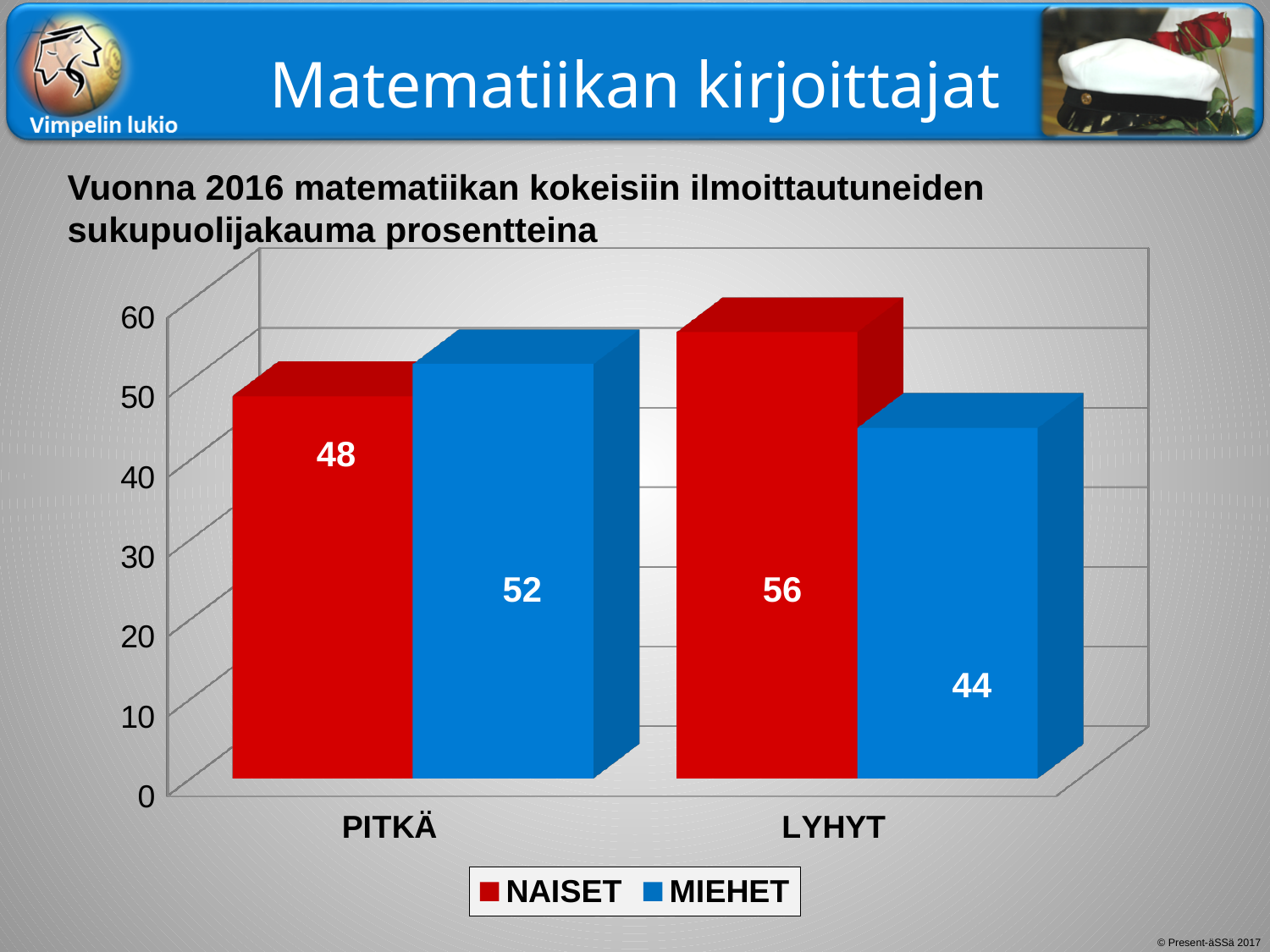
What kind of chart is shown on the slide? Bar chart Which colour represents the MIEHET series? Blue What is the value for NAISET in the PITKÄ category? 48 Which is larger: the NAISET value for PITKÄ or the NAISET value for LYHYT? LYHYT How many series does the legend list? 2 What is the value for MIEHET in the PITKÄ category? 52 What is the difference between the NAISET and MIEHET values in the LYHYT category? 12 Which series has the lowest value in the PITKÄ category? NAISET What is the value for NAISET in the LYHYT category? 56 How many categories are shown on the x axis? 2 What is the value for MIEHET in the LYHYT category? 44 Which series has the highest value in the LYHYT category? NAISET